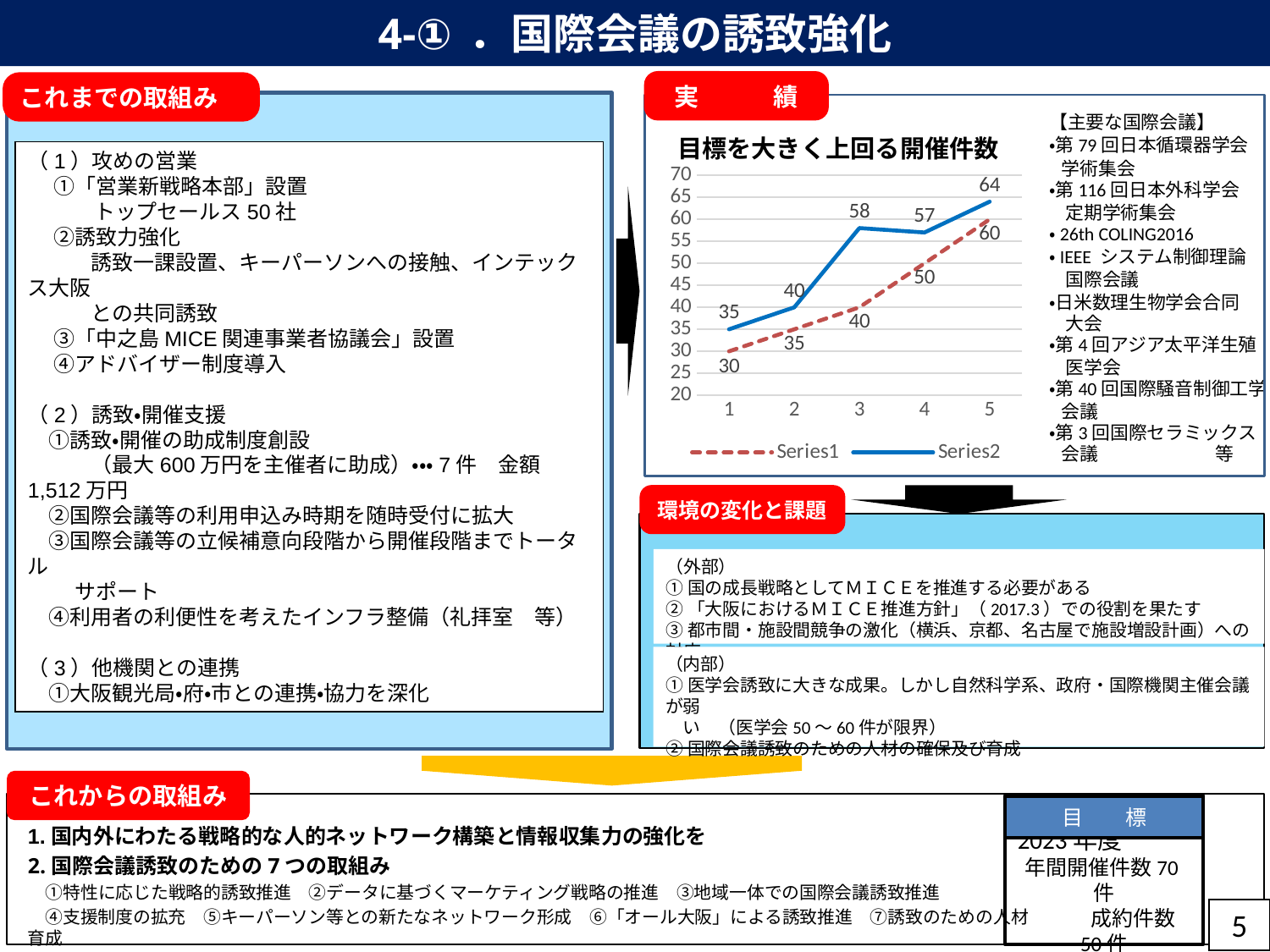
At which x value is Series1 at its lowest? 1 What is the title of the chart? 目標を大きく上回る開催件数 Do the values of Series1 rise or fall from x = 1 to x = 5? rise What is the value of Series2 at x = 3? 58 How many points are plotted along the x axis for each series? 5 What is the difference between Series2 and Series1 at x = 3? 18 What is the value of Series2 at x = 1? 35 What is the value of Series1 at x = 5? 60 At which x value does Series2 reach its highest value? 5 At x = 4, which series has the larger value, Series1 or Series2? Series2 How many series does the chart legend list? 2 What type of chart is shown on the slide? line chart